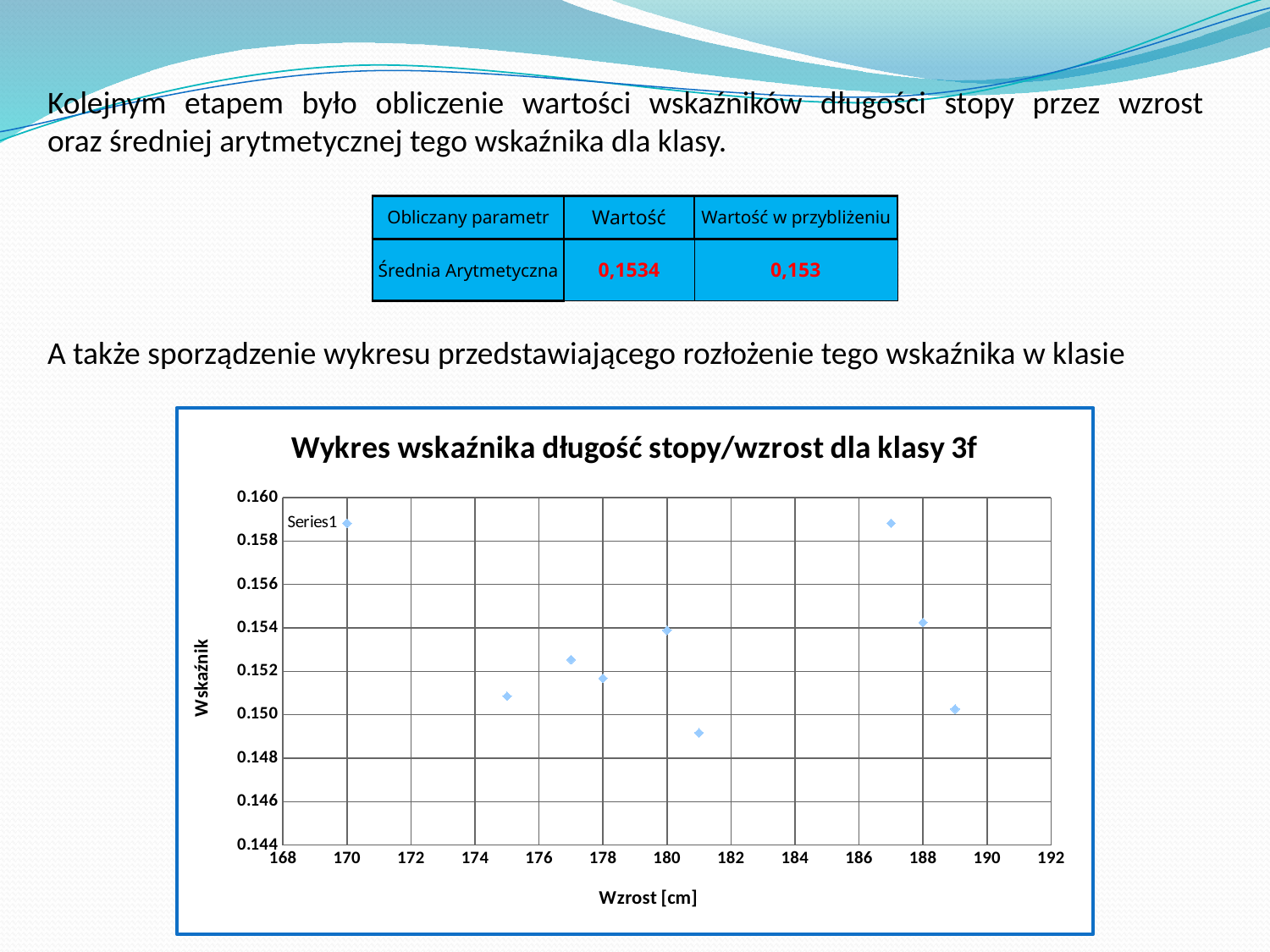
Is the Wskaźnik value for Wzrost 181 greater or less than 0.150? less How many data points are plotted on the chart? 9 Which Wzrost value has the lowest Wskaźnik on the chart? 181 Is the Wskaźnik value for Wzrost 180 greater or less than 0.152? greater What is the label of the x axis of the chart? Wzrost [cm] What kind of chart is shown on the slide? scatter chart Which has the larger Wskaźnik value: Wzrost 180 or Wzrost 181? 180 Which has the larger Wskaźnik value: Wzrost 188 or Wzrost 189? 188 Is the Wskaźnik value for Wzrost 175 greater or less than 0.152? less What is the title of the chart? Wykres wskaźnika długość stopy/wzrost dla klasy 3f